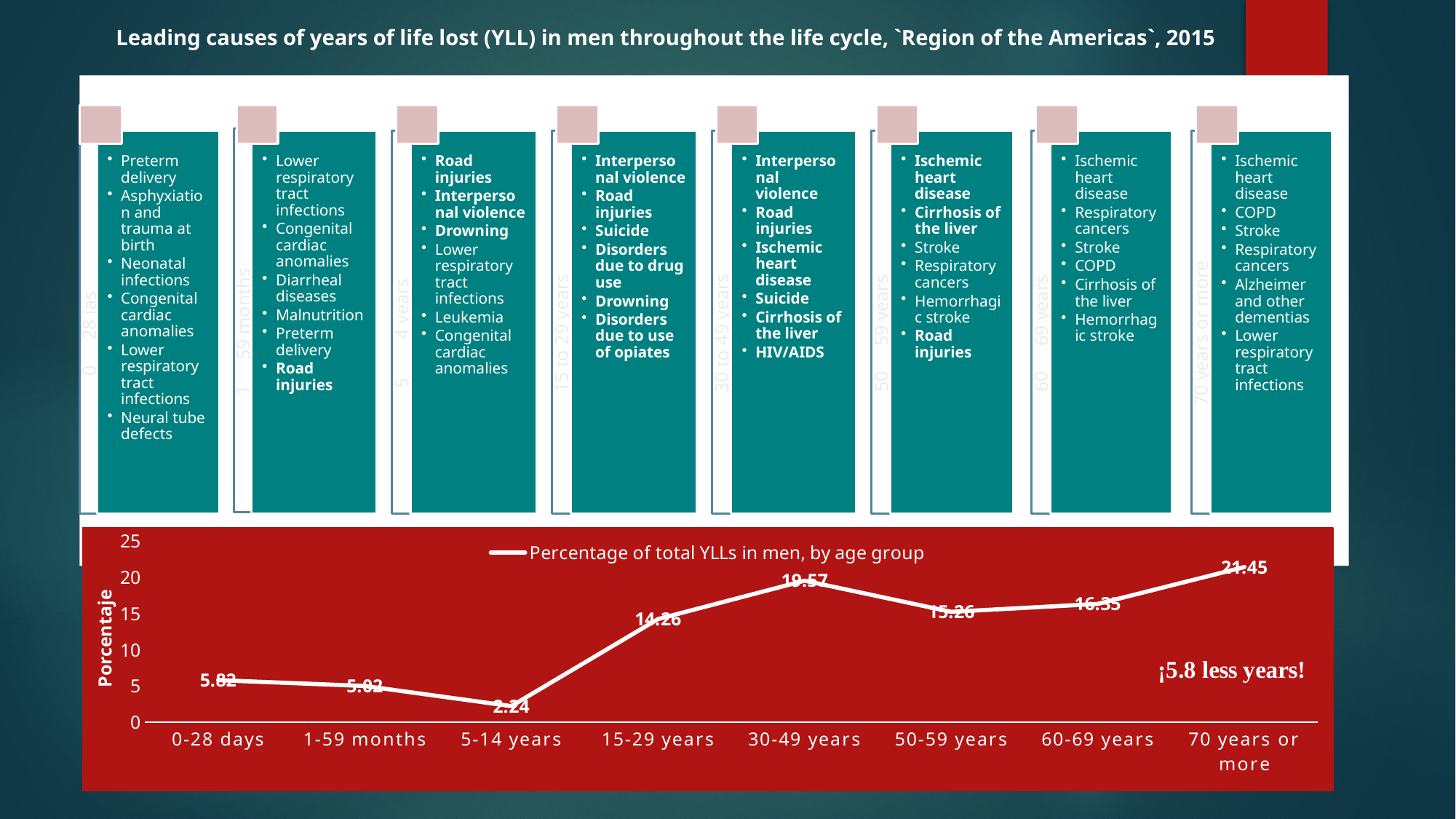
What is the percentage of total YLLs in men for the 0-28 days age group? 5.82 Which has a larger percentage of total YLLs in men: 15-29 years or 50-59 years? 50-59 years How many series does the legend of the line chart list? 1 Is the value for 1-59 months greater or less than 10? less What is the percentage of total YLLs in men for the 30-49 years age group? 19.57 What is the percentage of total YLLs in men for the 5-14 years age group? 2.24 Which age group has the lowest percentage of total YLLs in men? 5-14 years Which age group has the highest percentage of total YLLs in men? 70 years or more What is the difference between the percentage for 70 years or more and the percentage for 60-69 years? 5.1 What type of chart is shown at the bottom of the slide? Line chart What is the label on the vertical axis of the line chart? Porcentaje How many age groups are plotted on the x axis of the line chart? 8